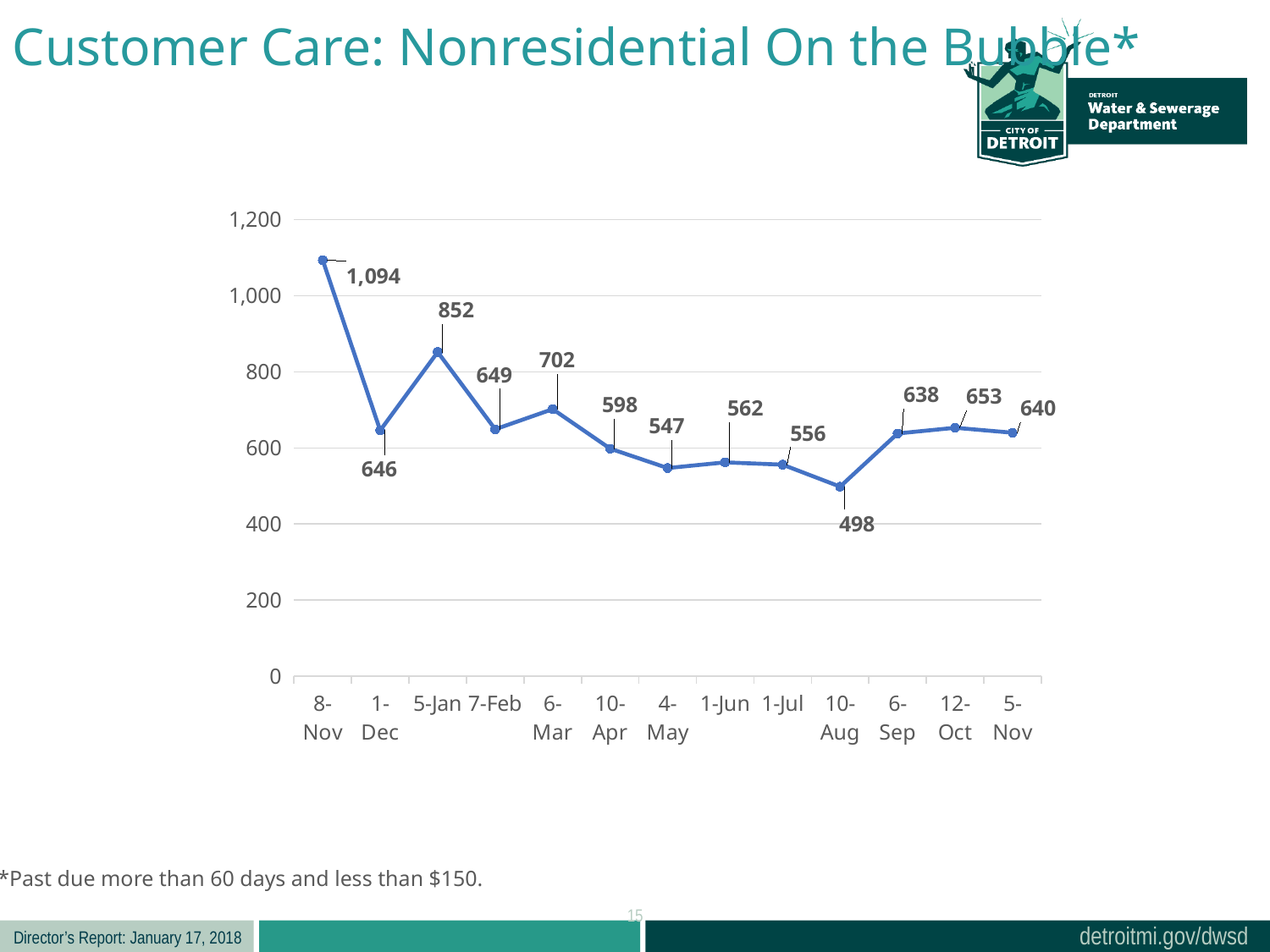
What kind of chart is shown on the slide? line chart Which is larger, the value for 6-Mar or the value for 10-Apr? 6-Mar What is the difference between the values for 8-Nov and 1-Dec? 448 What is the difference between the values for 12-Oct and 6-Sep? 15 What is the value for 10-Aug? 498 What is the value for 8-Nov? 1,094 What is the value for 5-Jan? 852 Does the value rise or fall from 8-Nov to 1-Dec? fall Which date has the highest value? 8-Nov Is the value for 5-Jan greater or less than 800? greater Which date has the lowest value? 10-Aug How many data points are plotted on the chart? 13